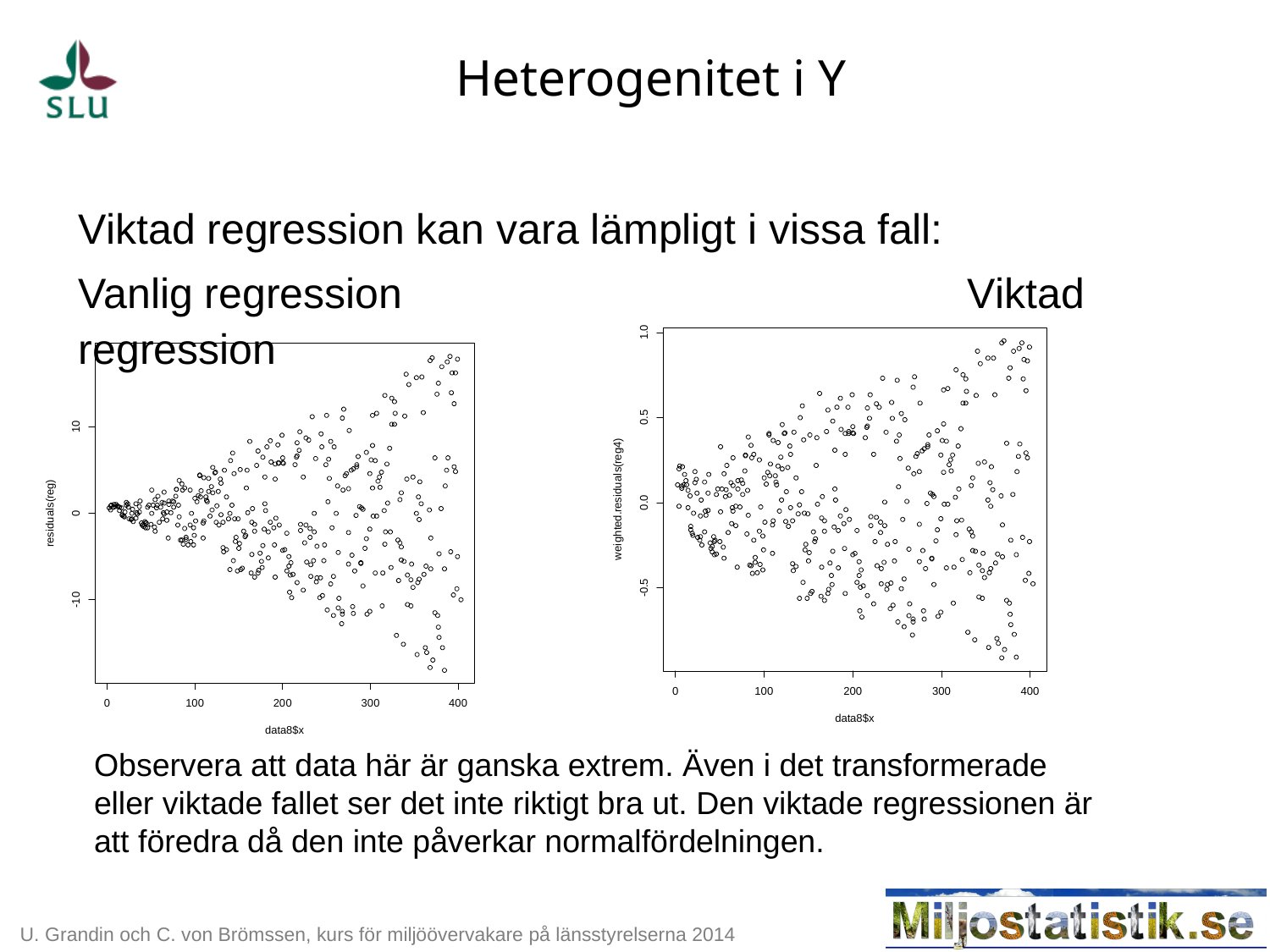
What kind of chart is the left chart (Vanlig regression)? scatter plot What kind of chart is the right chart (Viktad regression)? scatter plot What is the highest tick value shown on the y axis of the right chart (Viktad regression)? 1.0 In the left chart (Vanlig regression), does the spread of the residuals increase or decrease as data8$x increases? increase In the left chart (Vanlig regression), are the residuals near data8$x = 0 closer to 0 or to 10? 0 What is the x-axis label of the left chart (Vanlig regression)? data8$x What is the lowest tick value shown on the y axis of the left chart (Vanlig regression)? -10 What is the y-axis label of the right chart (Viktad regression)? weighted.residuals(reg4) Which chart has the larger range of y-axis values, the left chart (Vanlig regression) or the right chart (Viktad regression)? the left chart (Vanlig regression) What is the highest tick value shown on the x axis of the right chart (Viktad regression)? 400 How many charts are shown on the slide? 2